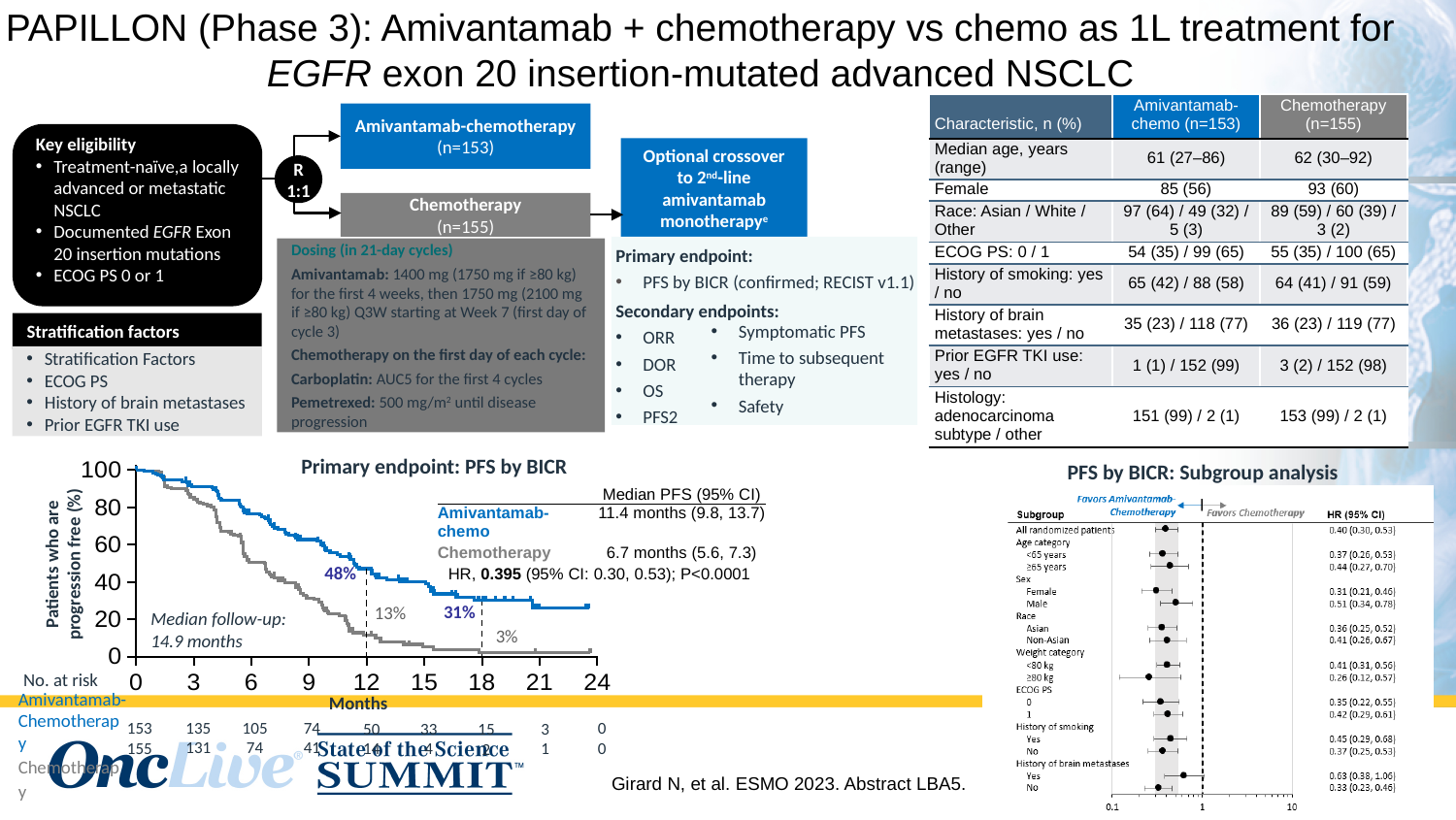
In the 'Primary endpoint: PFS by BICR' chart, what is the hazard ratio shown? 0.395 In the 'Primary endpoint: PFS by BICR' chart, do the curves rise or fall as months increase? Fall What kind of chart is the 'Primary endpoint: PFS by BICR' chart? Line chart (Kaplan-Meier curve) In the 'Primary endpoint: PFS by BICR' chart, how many treatment arms are plotted? 2 In the 'Primary endpoint: PFS by BICR' chart, what percentage of amivantamab-chemotherapy patients are progression free at 12 months? 48% In the 'Primary endpoint: PFS by BICR' chart, which arm has the higher progression-free percentage at 18 months? Amivantamab-chemo In the 'Primary endpoint: PFS by BICR' chart, what is the median PFS for the chemotherapy arm? 6.7 months In the 'PFS by BICR: Subgroup analysis' forest plot, which subgroup has the highest hazard ratio? History of brain metastases: Yes In the 'PFS by BICR: Subgroup analysis' forest plot, which subgroup has the lowest hazard ratio? Weight category ≥80 kg In the 'Primary endpoint: PFS by BICR' chart, what percentage of chemotherapy patients are progression free at 18 months? 3% In the 'Primary endpoint: PFS by BICR' chart, what is the difference between the 12-month progression-free percentages of the amivantamab-chemotherapy and chemotherapy arms? 35% In the 'PFS by BICR: Subgroup analysis' forest plot, what is the HR (95% CI) for all randomized patients? 0.40 (0.30, 0.53)